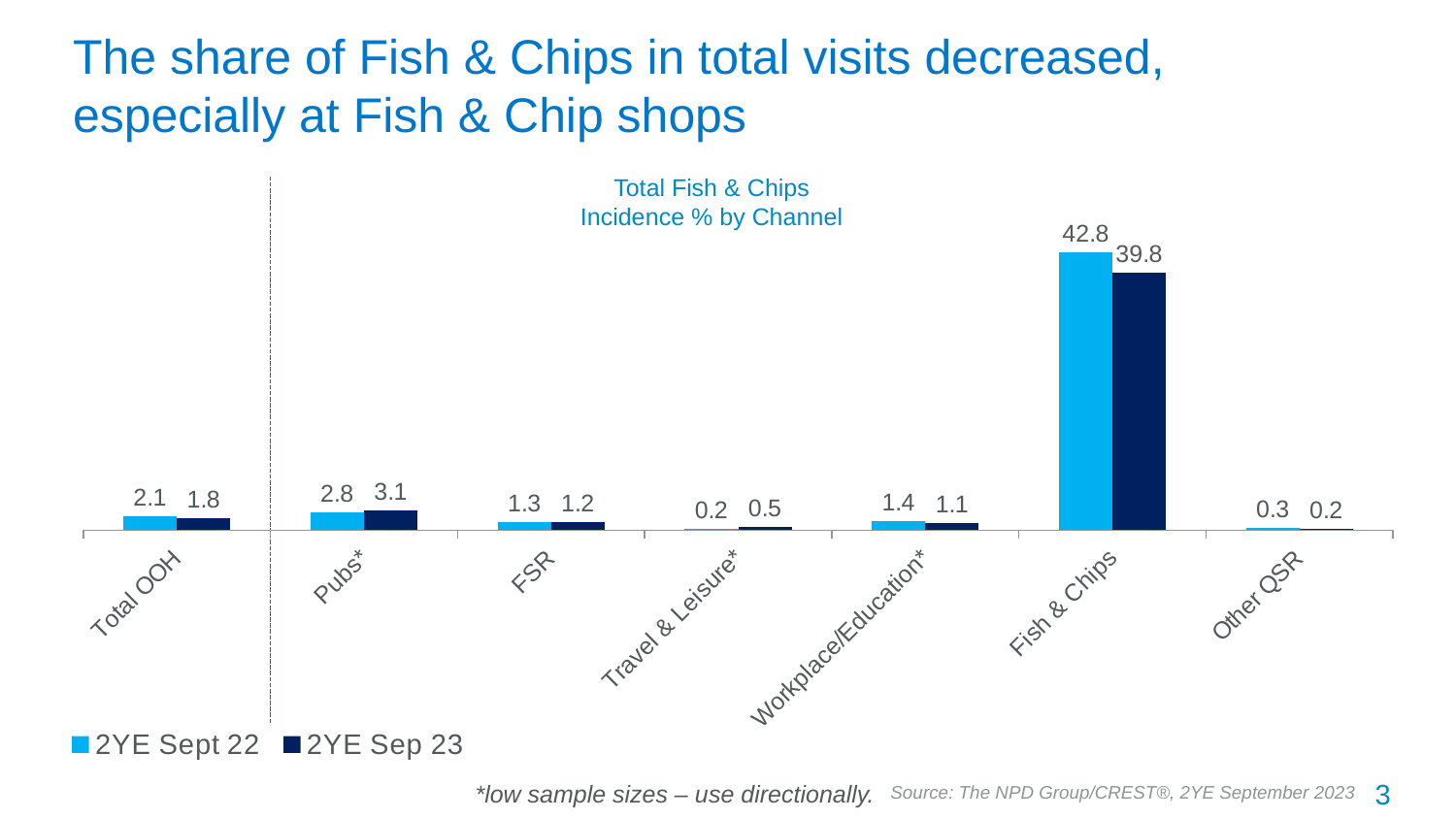
What is the value for Workplace/Education* in the 2YE Sep 23 series? 1.1 What is the title of the chart? Total Fish & Chips Incidence % by Channel Which channel has the lowest value in the 2YE Sept 22 series? Travel & Leisure* What is the value for Total OOH in the 2YE Sep 23 series? 1.8 What is the difference between the 2YE Sept 22 and 2YE Sep 23 values for Fish & Chips? 3.0 What kind of chart is shown on the slide? Bar chart How many channels are shown on the x axis? 7 What is the value for Pubs* in the 2YE Sep 23 series? 3.1 Which channel has the highest value in the 2YE Sept 22 series? Fish & Chips Which is larger for Pubs*: the 2YE Sept 22 value or the 2YE Sep 23 value? 2YE Sep 23 What is the value for Fish & Chips in the 2YE Sept 22 series? 42.8 How many series does the legend list? 2